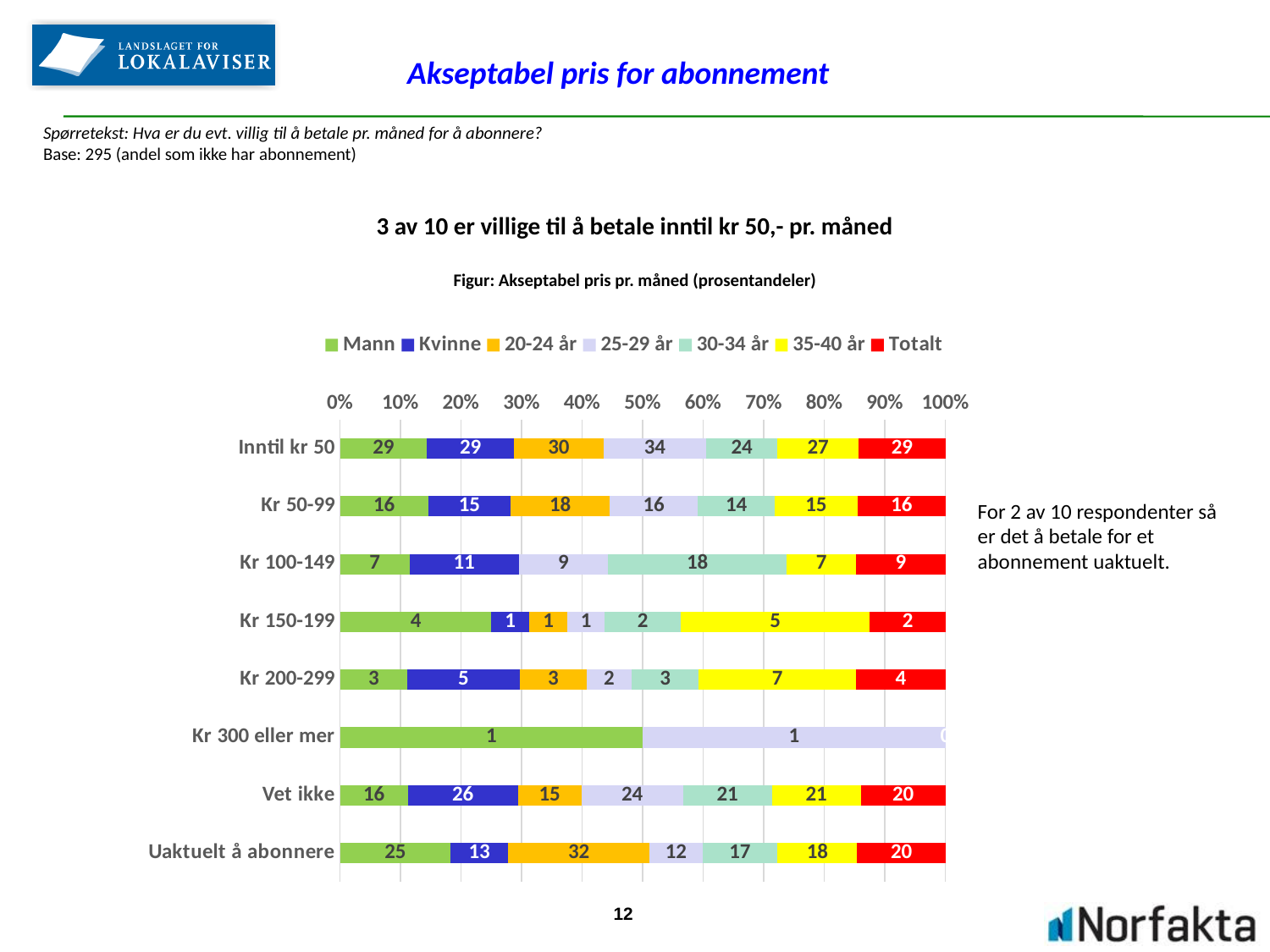
Which category has the highest Totalt value? Inntil kr 50 What is the 35-40 år value for "Kr 200-299"? 7 How many categories are shown on the vertical axis of the chart? 8 What is the difference between the Totalt values for "Inntil kr 50" and "Kr 50-99"? 13 What is the Kvinne value for "Vet ikke"? 26 What is the Totalt value for "Inntil kr 50"? 29 For "Vet ikke", which is larger: the Mann value or the Kvinne value? Kvinne What is the 20-24 år value for "Uaktuelt å abonnere"? 32 Which colour represents the Totalt series in the chart? Red What kind of chart is shown on the slide? Stacked bar chart How many series does the legend list? 7 What is the 30-34 år value for "Kr 100-149"? 18